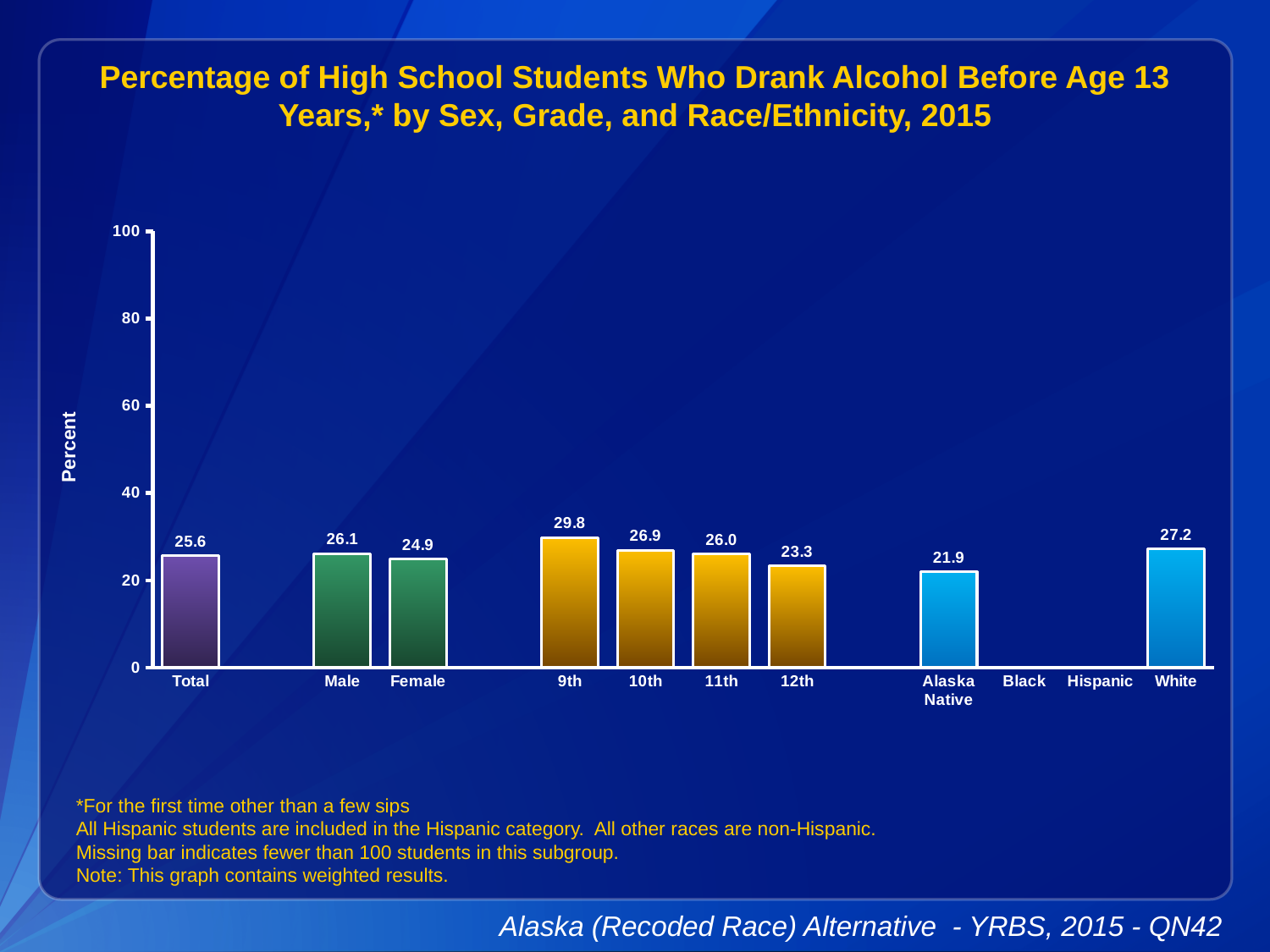
What kind of chart is shown? bar chart What is the value for Female? 24.9 Which is larger, the value for White or the value for 10th grade? White What is the value for 12th grade? 23.3 Do the values rise or fall from 9th grade to 12th grade? fall What is the value for Alaska Native? 21.9 Which category has the highest value? 9th Is the value for 9th grade greater or less than 40? less What is the difference between the Male and Female values? 1.2 How many categories have a bar plotted? 9 What is the value for Total? 25.6 Which category with a bar has the lowest value? Alaska Native